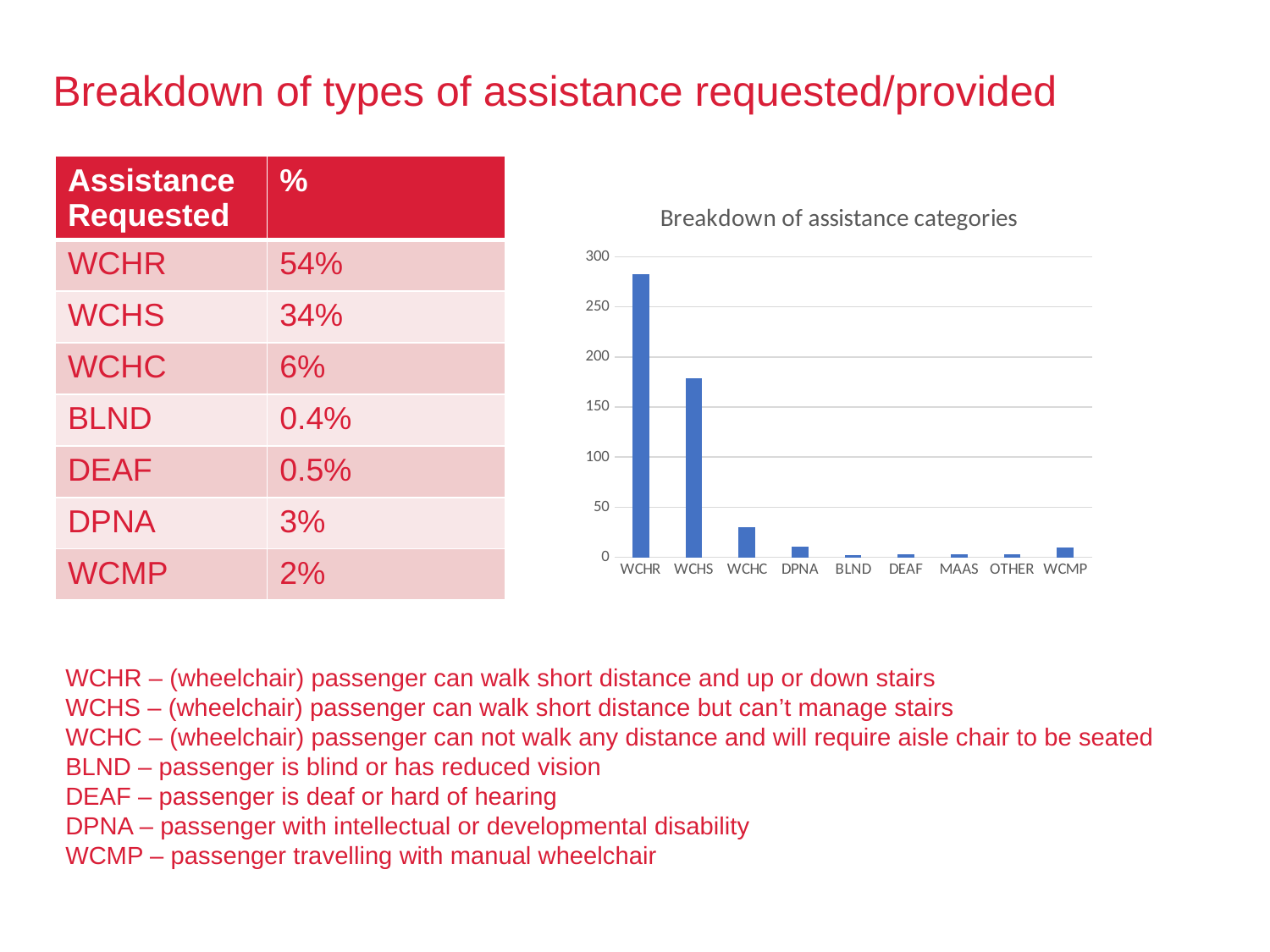
How many categories are shown on the x axis of the chart? 9 Is the value for WCHS greater or less than 150? greater Is the value for WCHS greater or less than 200? less Is the value for WCHR greater or less than 250? greater What colour are the bars in the chart? blue Do the values rise or fall from WCHR to WCHC along the x axis? fall What type of chart is shown on the slide? bar chart Which category has the highest value in the chart? WCHR What is the title of the chart? Breakdown of assistance categories Which is larger, the value for WCHR or the value for WCHS? WCHR Which is larger, the value for WCHC or the value for DPNA? WCHC